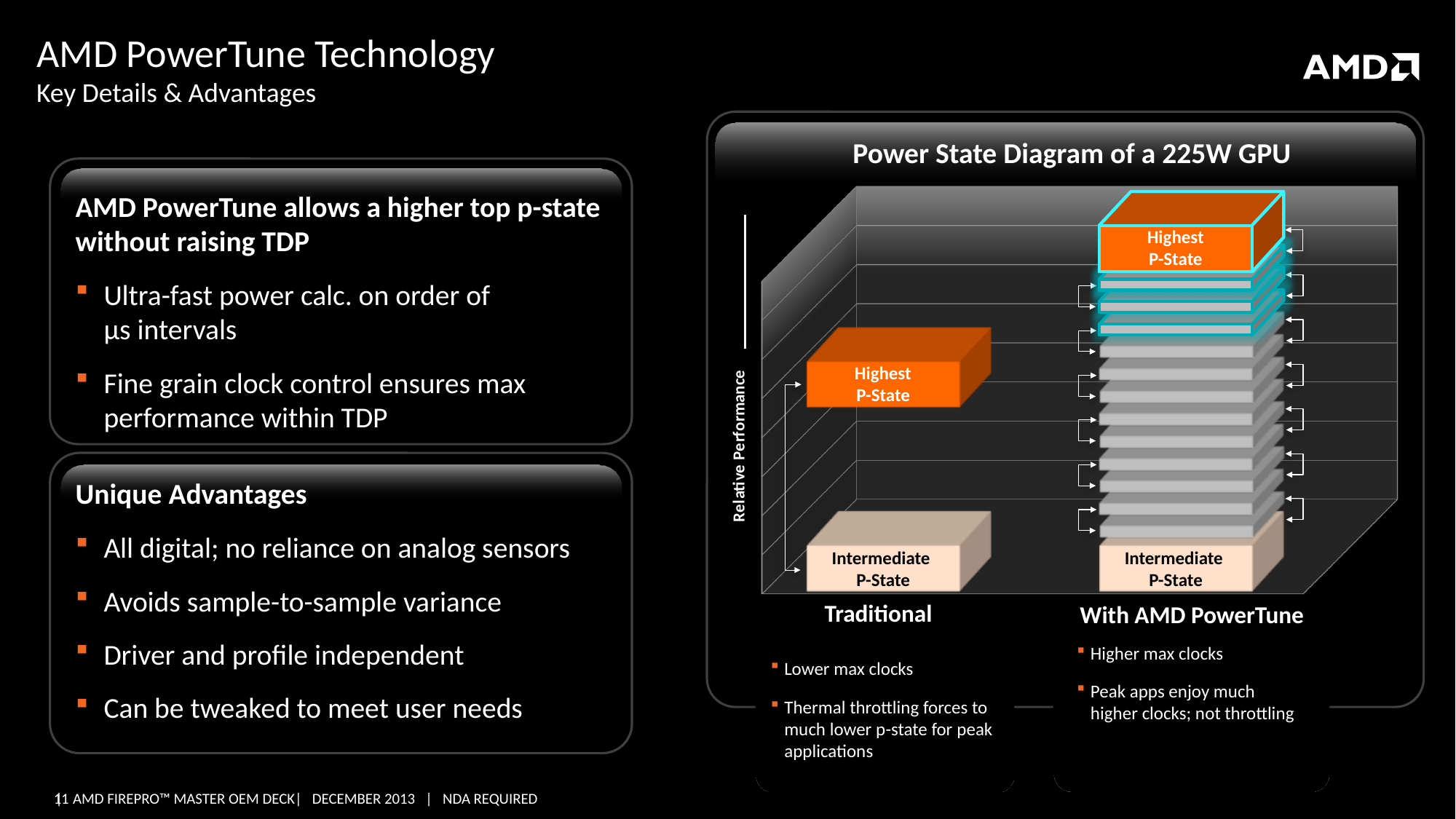
In the Power State Diagram, which configuration shows its Highest P-State at a higher relative performance, Traditional or With AMD PowerTune? With AMD PowerTune What is the title of the diagram on the right side of the slide? Power State Diagram of a 225W GPU In the Power State Diagram, which configuration has the lower Highest P-State in relative performance? Traditional In the Power State Diagram, what is the label on the vertical axis? Relative Performance How many GPU configurations are compared in the Power State Diagram? 2